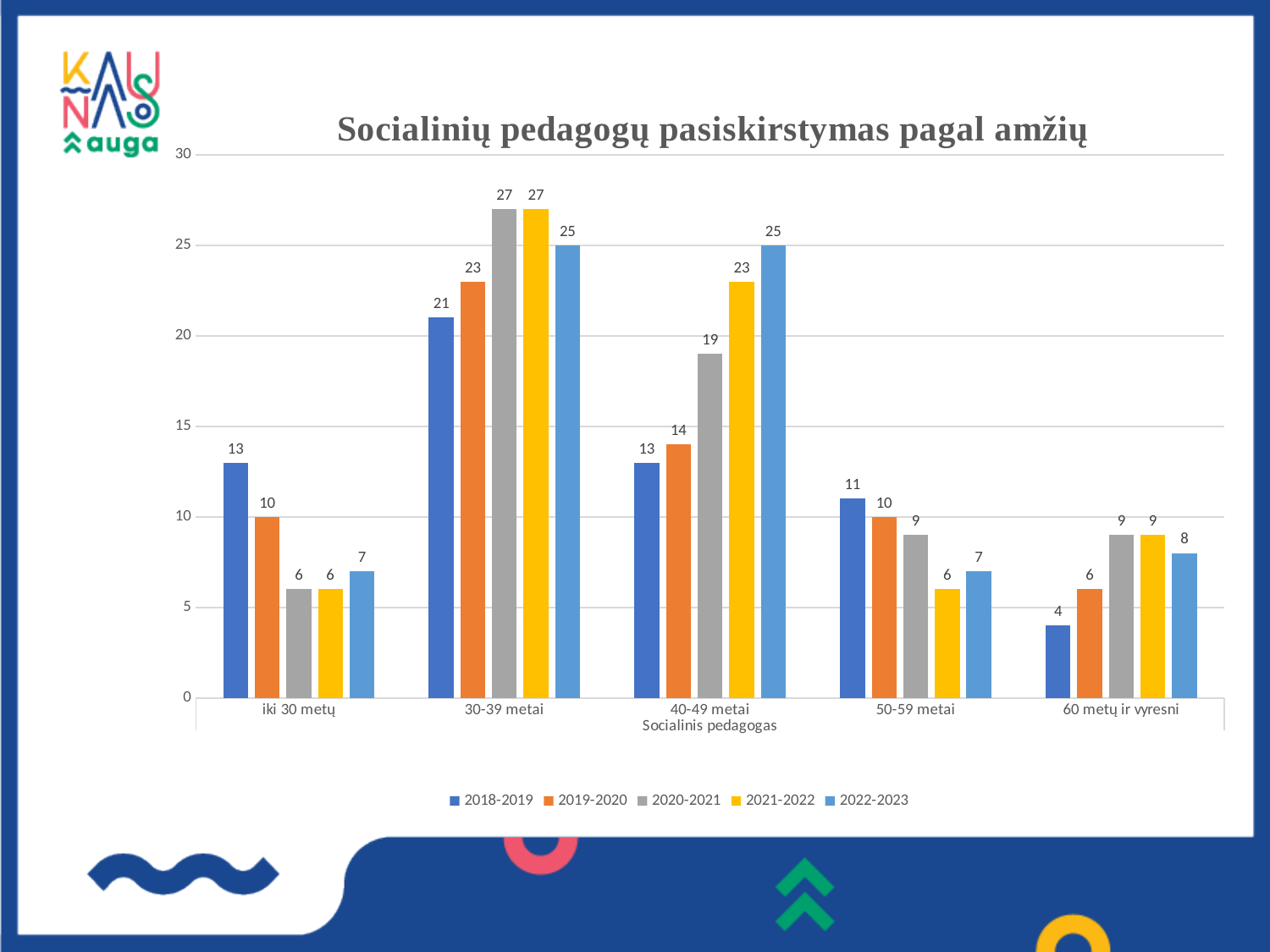
Which category has the lowest value for the 2018-2019 series? 60 metų ir vyresni What is the difference between the 2021-2022 and 2018-2019 values in the 40-49 metai category? 10 How many series does the legend list? 5 What is the value for 2022-2023 in the 40-49 metai category? 25 What is the value for 2021-2022 in the 50-59 metai category? 6 Which is larger in the 60 metų ir vyresni category: the 2019-2020 value or the 2020-2021 value? 2020-2021 Do the values for the 2018-2019 series rise or fall from 50-59 metai to 60 metų ir vyresni? fall What is the value for 2018-2019 in the iki 30 metų category? 13 What kind of chart is shown on the slide? bar chart What is the title of the chart? Socialinių pedagogų pasiskirstymas pagal amžių Which category has the highest value for the 2022-2023 series? 30-39 metai and 40-49 metai (tied at 25) How many age categories are shown on the x axis? 5